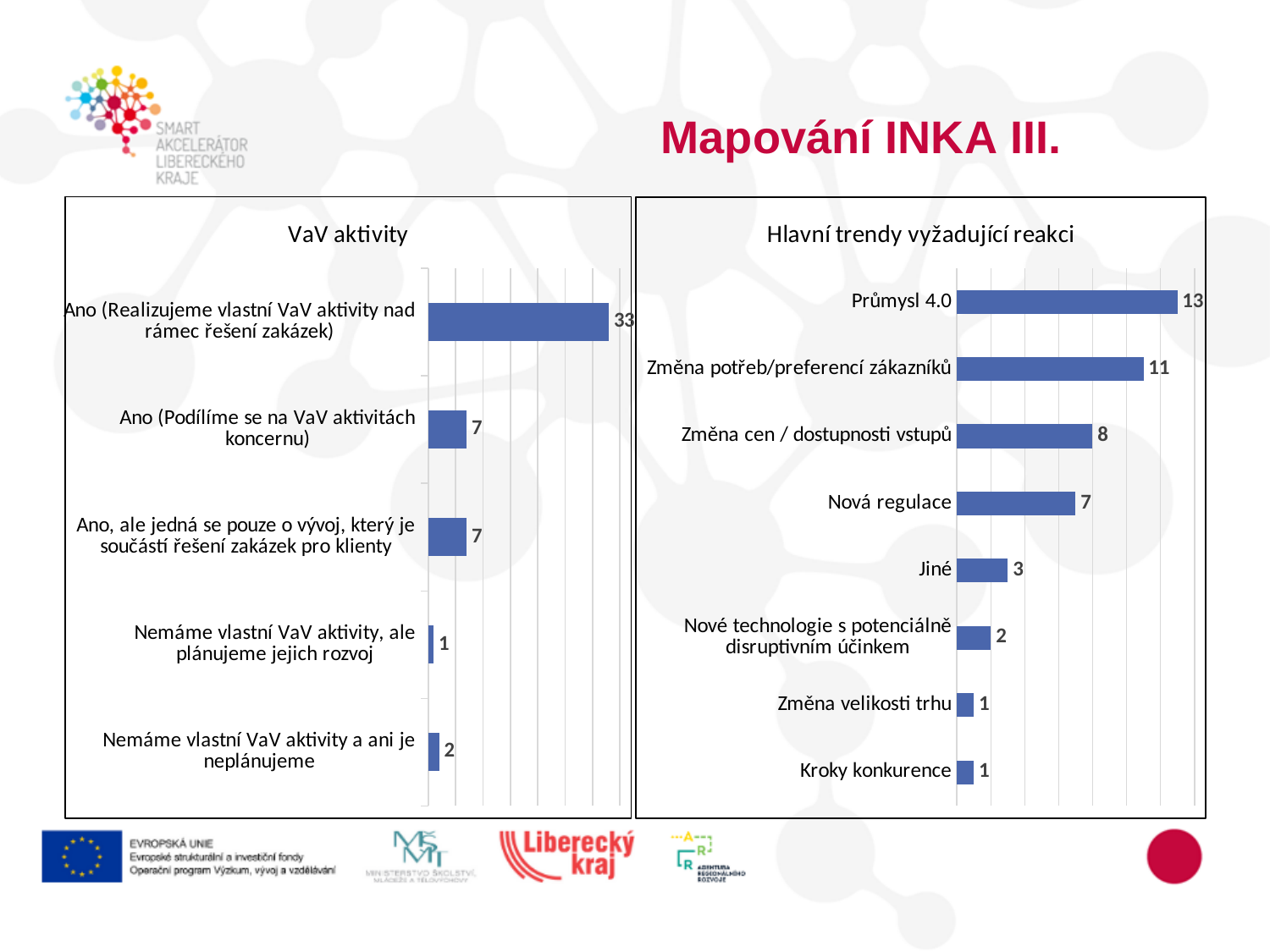
In the 'Hlavní trendy vyžadující reakci' chart, which is larger: 'Nová regulace' or 'Jiné'? Nová regulace In the 'VaV aktivity' chart, which category has the lowest value? Nemáme vlastní VaV aktivity, ale plánujeme jejich rozvoj In the 'VaV aktivity' chart, how many categories are shown? 5 In the 'VaV aktivity' chart, what is the value for 'Ano (Realizujeme vlastní VaV aktivity nad rámec řešení zakázek)'? 33 In the 'Hlavní trendy vyžadující reakci' chart, what is the value for 'Nové technologie s potenciálně disruptivním účinkem'? 2 In the 'Hlavní trendy vyžadující reakci' chart, what is the difference between 'Průmysl 4.0' and 'Změna potřeb/preferencí zákazníků'? 2 In the 'Hlavní trendy vyžadující reakci' chart, which category has the highest value? Průmysl 4.0 In the 'VaV aktivity' chart, what type of chart is used? Bar chart In the 'Hlavní trendy vyžadující reakci' chart, what is the value for 'Změna cen / dostupnosti vstupů'? 8 In the 'VaV aktivity' chart, what is the difference between 'Ano (Realizujeme vlastní VaV aktivity nad rámec řešení zakázek)' and 'Ano (Podílíme se na VaV aktivitách koncernu)'? 26 In the 'Hlavní trendy vyžadující reakci' chart, how many categories are shown? 8 What is the title of the chart on the left side of the slide? VaV aktivity